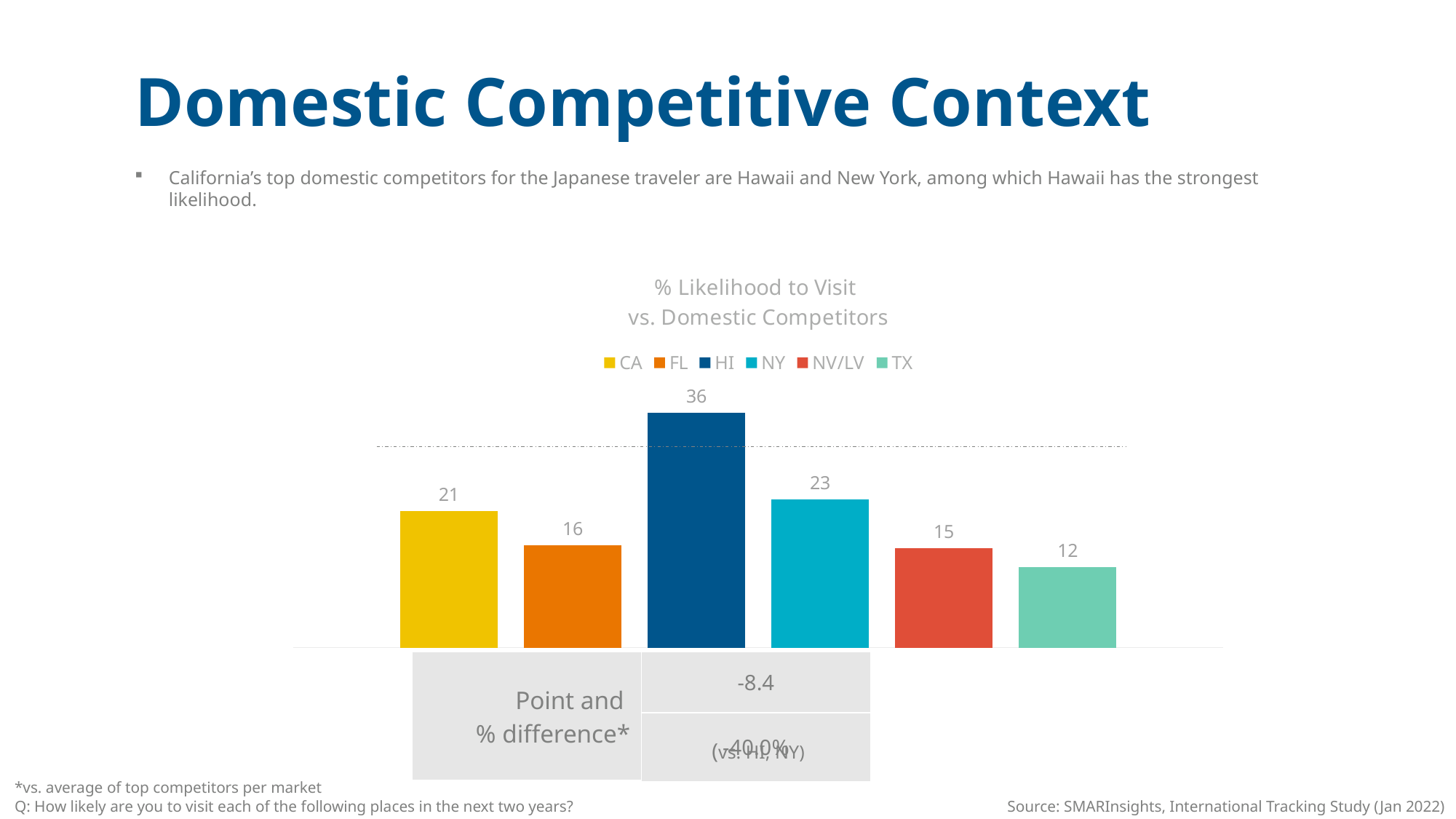
What type of chart is shown on the slide? Bar chart How many destinations are shown in the chart? 6 What is the % likelihood to visit for HI? 36 Which has a higher % likelihood to visit, NY or CA? NY Which destination has the lowest % likelihood to visit? TX How many entries does the legend list? 6 What is the difference between the values for HI and NY? 13 What is the % likelihood to visit for TX? 12 What is the % likelihood to visit for NV/LV? 15 What is the % likelihood to visit for CA? 21 Which destination has the highest % likelihood to visit? HI What is the difference between the values for CA and FL? 5